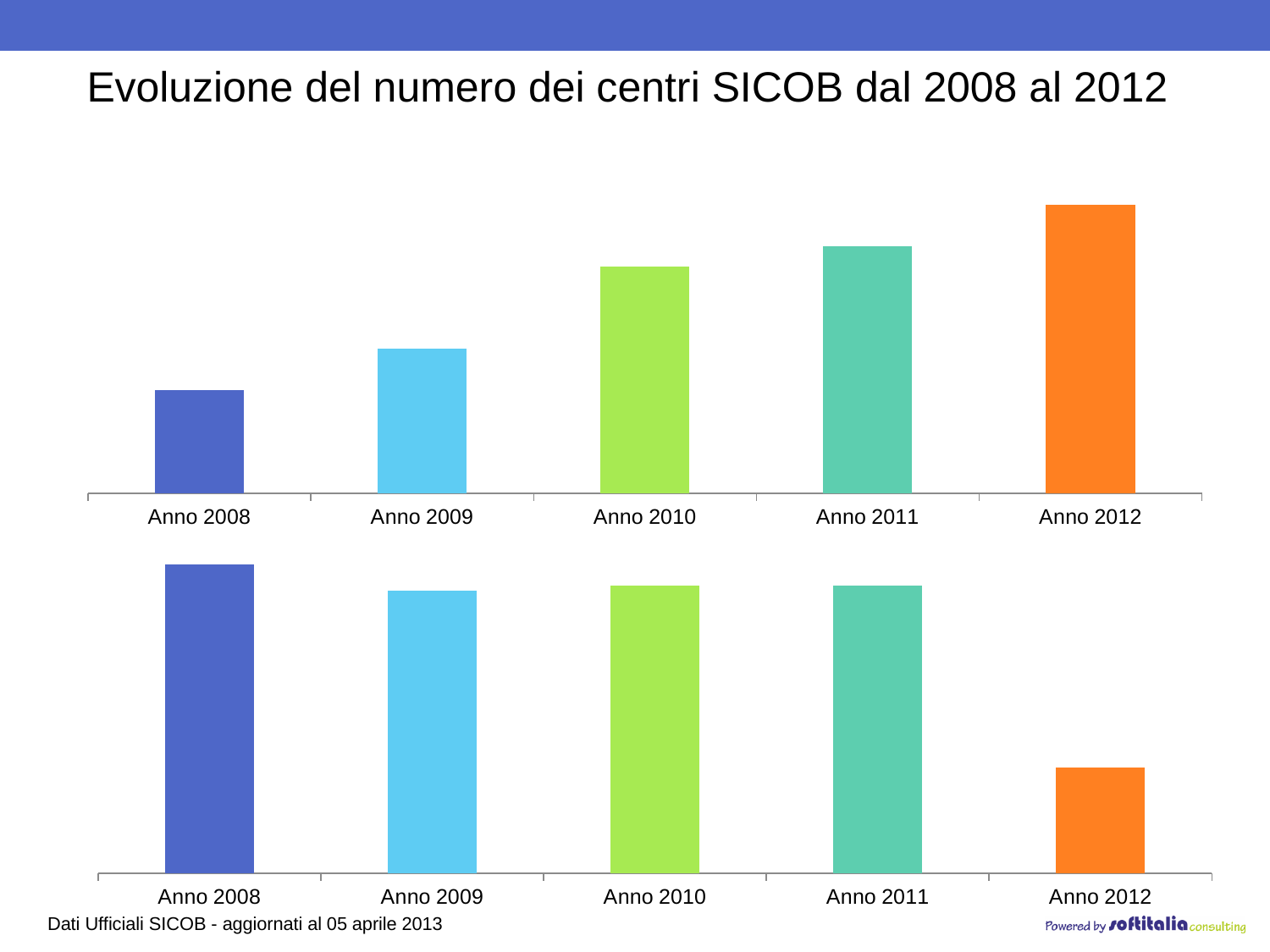
In the top chart, do the values rise or fall from Anno 2008 to Anno 2012? rise In the top chart, which category has the lowest bar? Anno 2008 In the top chart, which is larger, the bar for Anno 2009 or the bar for Anno 2011? Anno 2011 What kind of chart is the top chart on the slide? bar chart What kind of chart is the bottom chart on the slide? bar chart In the top chart, which category has the highest bar? Anno 2012 In the bottom chart, which is larger, the bar for Anno 2008 or the bar for Anno 2012? Anno 2008 In the top chart, what colour is the bar for Anno 2012? orange What is the title of the slide containing the charts? Evoluzione del numero dei centri SICOB dal 2008 al 2012 In the top chart, how many categories are shown on the x axis? 5 In the bottom chart, which category has the lowest bar? Anno 2012 In the bottom chart, how many categories are shown on the x axis? 5